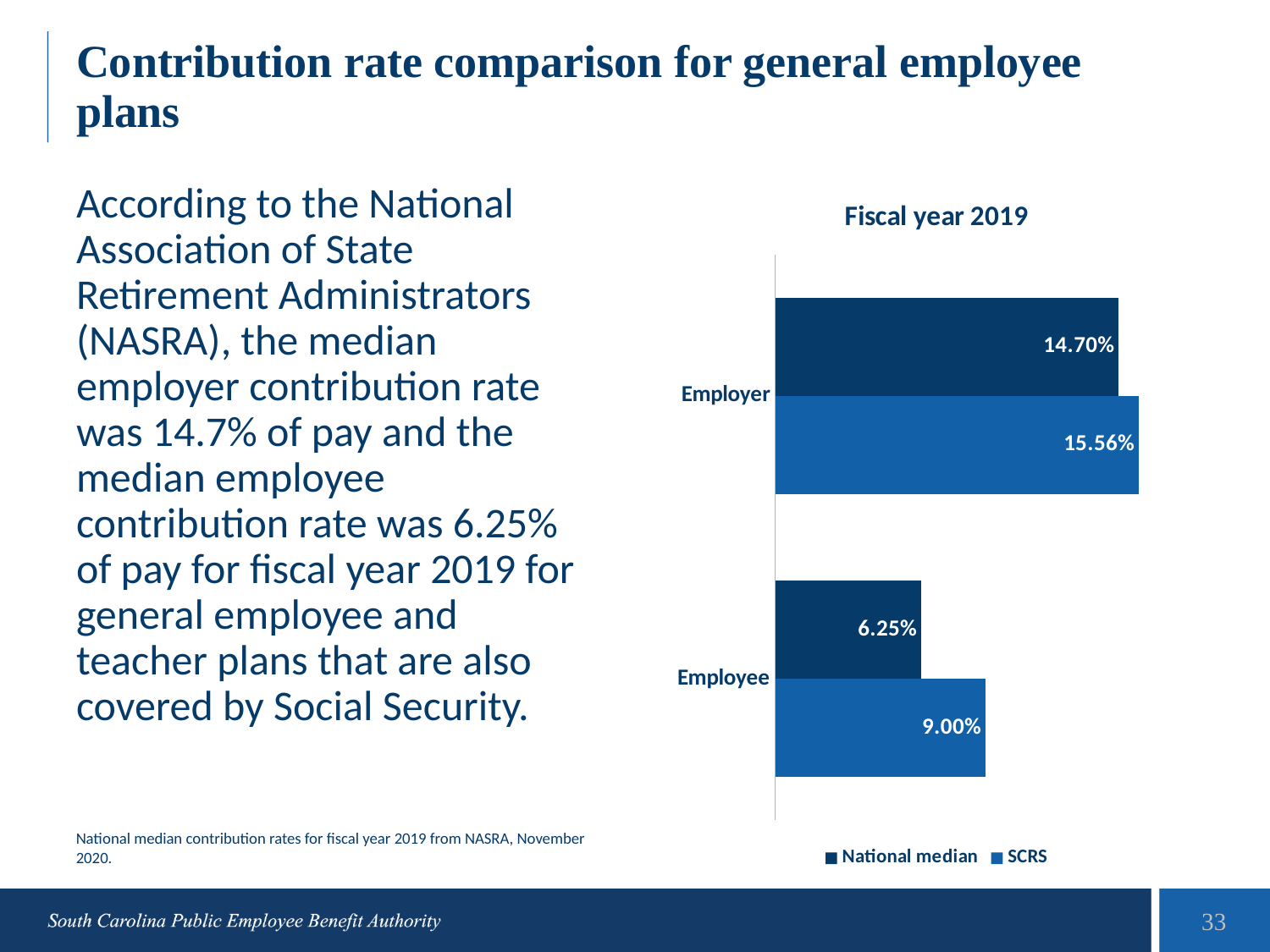
Which category has the lowest National median contribution rate? Employee For Employer, which is larger: the National median rate or the SCRS rate? SCRS How many categories are shown on the chart? 2 Which category has the highest SCRS contribution rate? Employer What is the National median contribution rate for Employer? 14.70% What is the difference between the SCRS and National median rates for Employee? 2.75% What kind of chart is shown on the slide? Bar chart How many series does the legend list? 2 What is the SCRS contribution rate for Employer? 15.56% What is the difference between the SCRS and National median rates for Employer? 0.86% What is the SCRS contribution rate for Employee? 9.00% What is the National median contribution rate for Employee? 6.25%